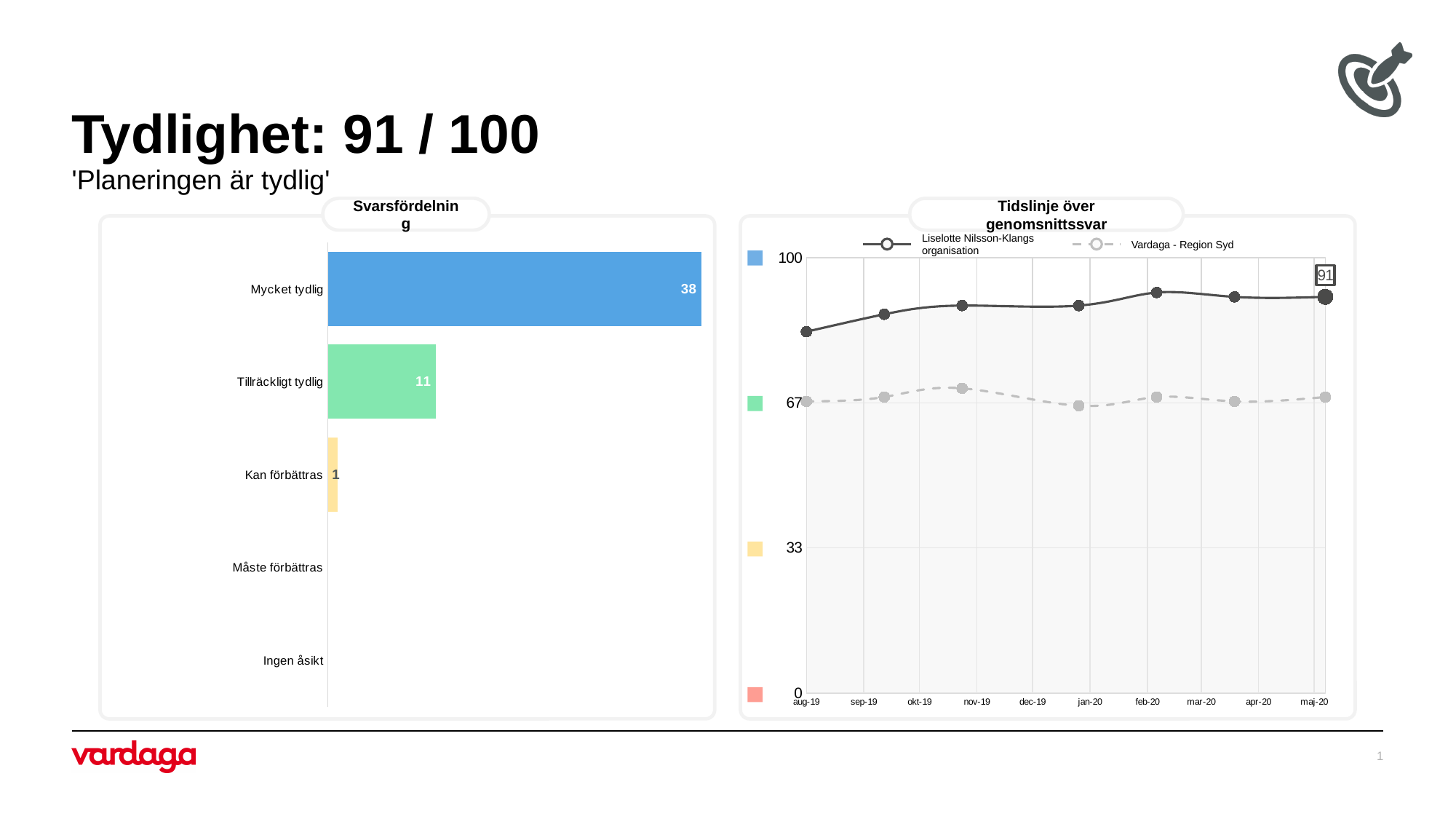
In the Svarsfördelning chart, which is larger: Tillräckligt tydlig or Kan förbättras? Tillräckligt tydlig In the Svarsfördelning chart, what is the value for Kan förbättras? 1 In the Svarsfördelning chart, what is the value for Mycket tydlig? 38 In the Tidslinje över genomsnittssvar chart, what is the value labelled for maj-20 on the Liselotte Nilsson-Klangs organisation series? 91 In the Svarsfördelning chart, how many categories are listed on the axis? 5 In the Svarsfördelning chart, what is the value for Tillräckligt tydlig? 11 In the Svarsfördelning chart, which category has the highest value? Mycket tydlig In the Tidslinje över genomsnittssvar chart, which series is drawn with a dashed line? Vardaga - Region Syd In the Svarsfördelning chart, what is the difference between Mycket tydlig and Tillräckligt tydlig? 27 In the Tidslinje över genomsnittssvar chart, how many series does the legend list? 2 What kind of chart is the Svarsfördelning chart? Bar chart